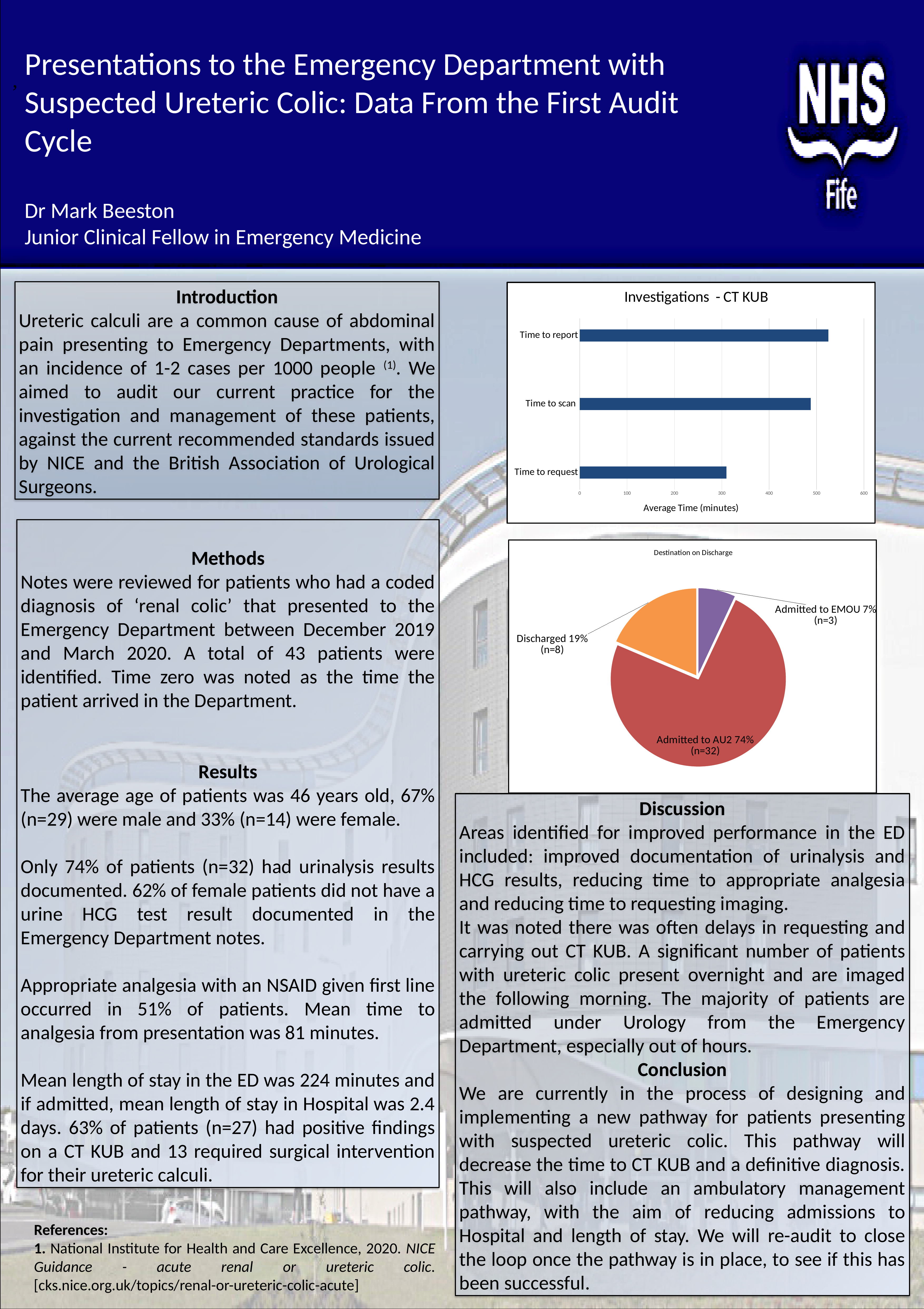
What kind of chart is the 'Destination on Discharge' chart? pie chart In the 'Destination on Discharge' chart, how many patients were Discharged? 8 What kind of chart is the 'Investigations - CT KUB' chart? bar chart In the 'Destination on Discharge' chart, what share of patients were Admitted to AU2? 74% In the 'Investigations - CT KUB' chart, is the value for Time to request greater or less than 400? less In the 'Investigations - CT KUB' chart, is the value for Time to scan greater or less than 400? greater In the 'Investigations - CT KUB' chart, which is larger, Time to scan or Time to request? Time to scan In the 'Investigations - CT KUB' chart, which category has the highest average time? Time to report In the 'Investigations - CT KUB' chart, which category has the lowest average time? Time to request What is the x-axis label of the 'Investigations - CT KUB' chart? Average Time (minutes) How many categories are shown in the 'Investigations - CT KUB' chart? 3 In the 'Destination on Discharge' chart, which destination has the smallest share? Admitted to EMOU